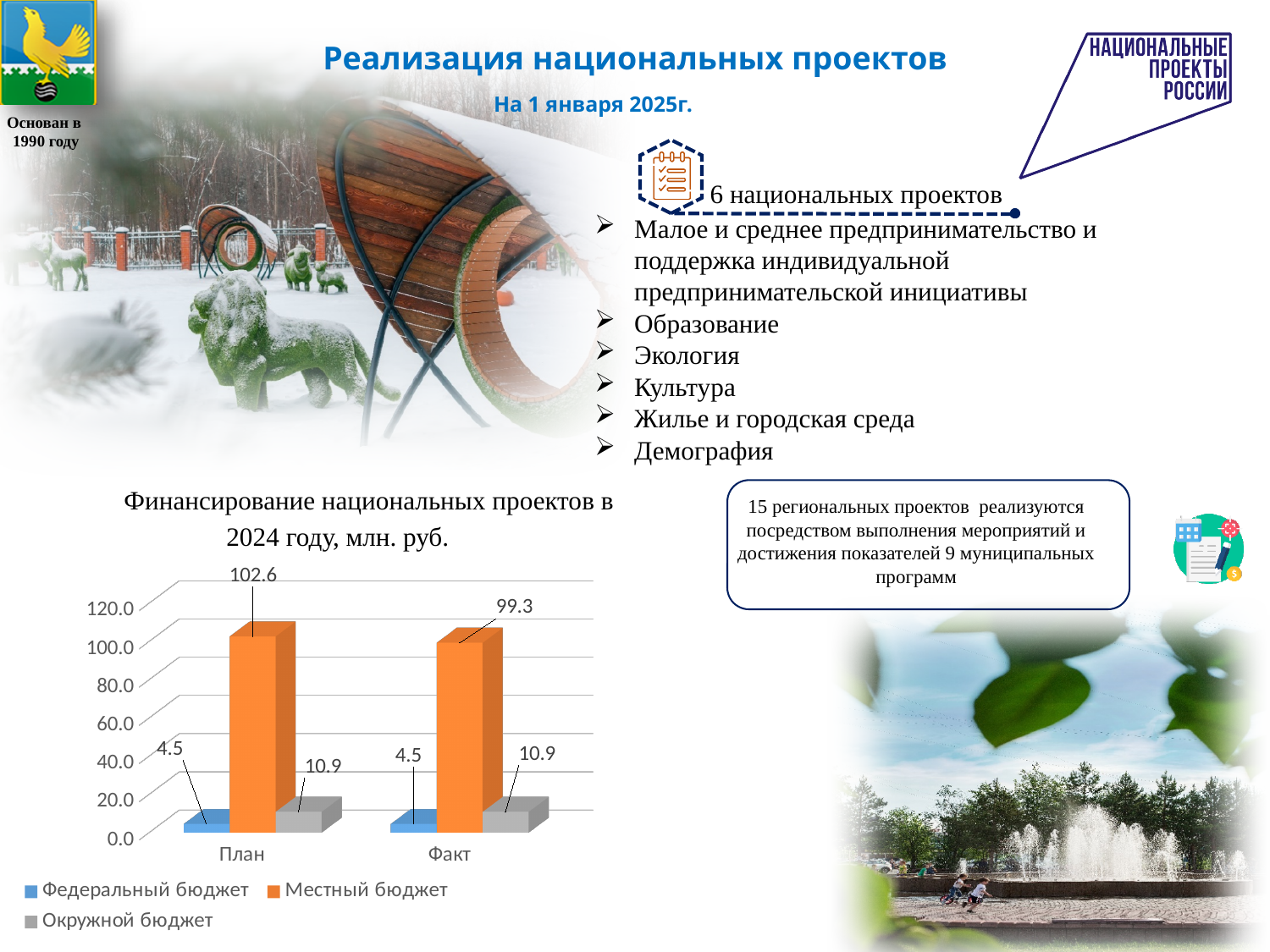
How many series does the legend list? 3 What is the value of Федеральный бюджет for Факт? 4.5 What is the title of the chart? Финансирование национальных проектов в 2024 году, млн. руб. What is the value of Местный бюджет for План? 102.6 Which is larger: Местный бюджет for План or Местный бюджет for Факт? План Which series has the lowest value for Факт? Федеральный бюджет What is the value of Местный бюджет for Факт? 99.3 Which series has the highest value for План? Местный бюджет How many categories are shown on the x axis? 2 What is the value of Окружной бюджет for План? 10.9 What kind of chart is shown on the slide? Bar chart What is the difference between Местный бюджет for План and for Факт? 3.3